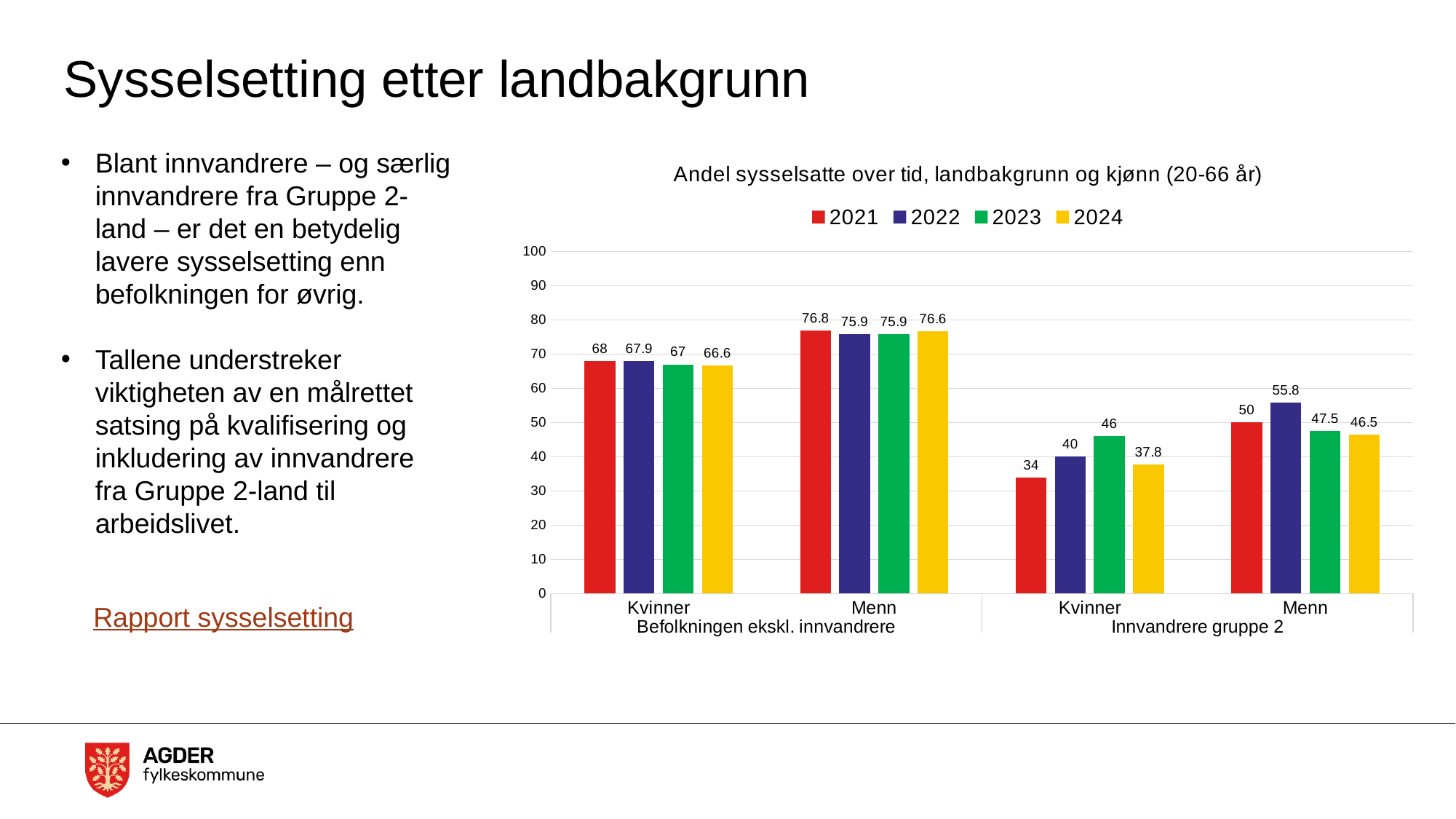
How many series does the legend list? 4 What is the difference between the 2023 and 2021 values for Kvinner in the Innvandrere gruppe 2 group? 12 Which is larger: the 2021 value for Menn in Befolkningen ekskl. innvandrere or the 2021 value for Menn in Innvandrere gruppe 2? Menn in Befolkningen ekskl. innvandrere What is the value for 2021 for Kvinner in the Befolkningen ekskl. innvandrere group? 68 What is the value for 2024 for Menn in the Innvandrere gruppe 2 group? 46.5 Do the values for Kvinner in the Befolkningen ekskl. innvandrere group rise or fall from 2021 to 2024? fall What is the title of the chart? Andel sysselsatte over tid, landbakgrunn og kjønn (20-66 år) What kind of chart is shown on the slide? bar chart What is the value for 2022 for Kvinner in the Innvandrere gruppe 2 group? 40 Which year has the highest value for Menn in the Innvandrere gruppe 2 group? 2022 Which year has the lowest value for Kvinner in the Innvandrere gruppe 2 group? 2021 Is the 2024 value for Kvinner in the Innvandrere gruppe 2 group greater or less than 40? less